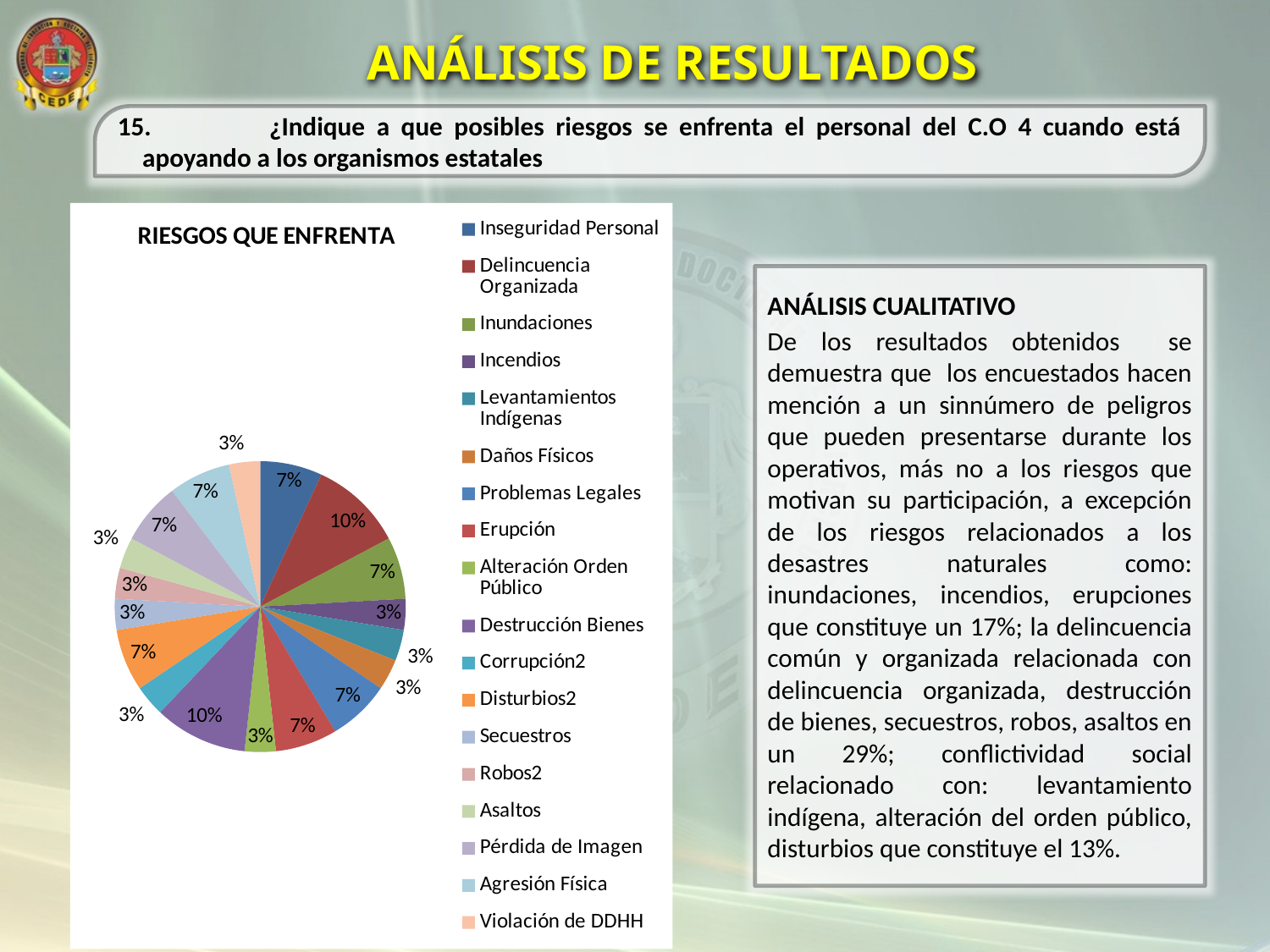
What kind of chart is shown under the title 'RIESGOS QUE ENFRENTA'? pie chart What share of the pie does 'Agresión Física' represent? 7% Which has a larger share in the pie chart, 'Delincuencia Organizada' or 'Inundaciones'? Delincuencia Organizada What percentage does the pie chart show for 'Delincuencia Organizada'? 10% What percentage does the pie chart show for 'Inseguridad Personal'? 7% What is the title of the pie chart? RIESGOS QUE ENFRENTA Which is larger in the pie chart, 'Destrucción Bienes' or 'Violación de DDHH'? Destrucción Bienes What is the difference in percentage points between 'Delincuencia Organizada' and 'Inseguridad Personal' in the pie chart? 3 What percentage does the pie chart show for 'Destrucción Bienes'? 10% What percentage does the pie chart show for 'Inundaciones'? 7% What percentage does the pie chart show for 'Violación de DDHH'? 3% How many categories does the legend of the pie chart list? 18